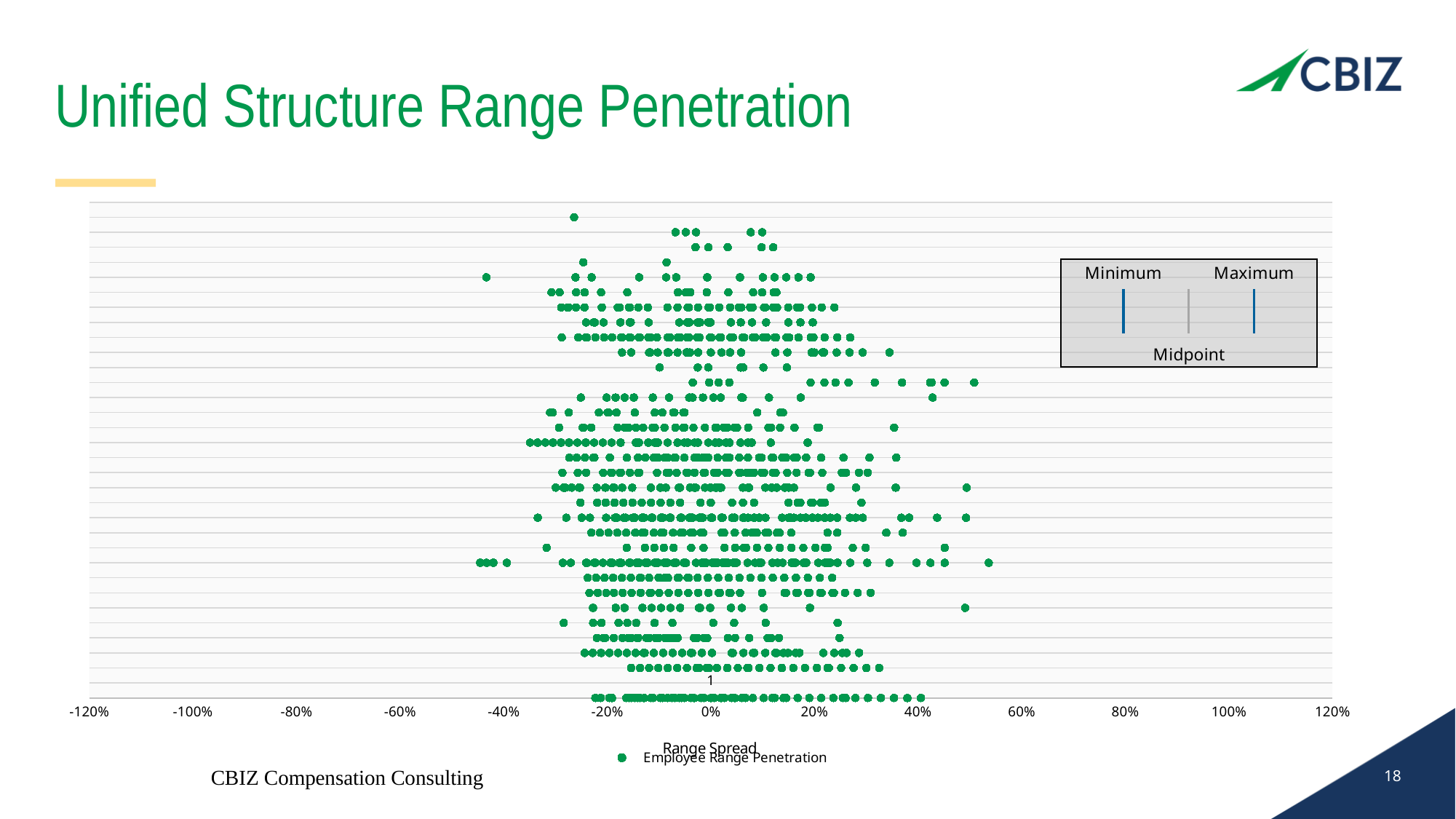
What is the lowest value shown on the x axis? -120% Are any plotted points located beyond 80% on the x axis? No What colour are the plotted points in the chart? green What is the highest value shown on the x axis? 120% Is the rightmost plotted point greater or less than 60%? less Is the leftmost plotted point greater or less than -60%? greater What is the name of the series shown in the chart legend? Employee Range Penetration What kind of chart is shown on the slide? scatter chart How many tick labels are shown on the x axis? 13 What is the title of the slide's chart? Unified Structure Range Penetration How many series does the chart legend list? 1